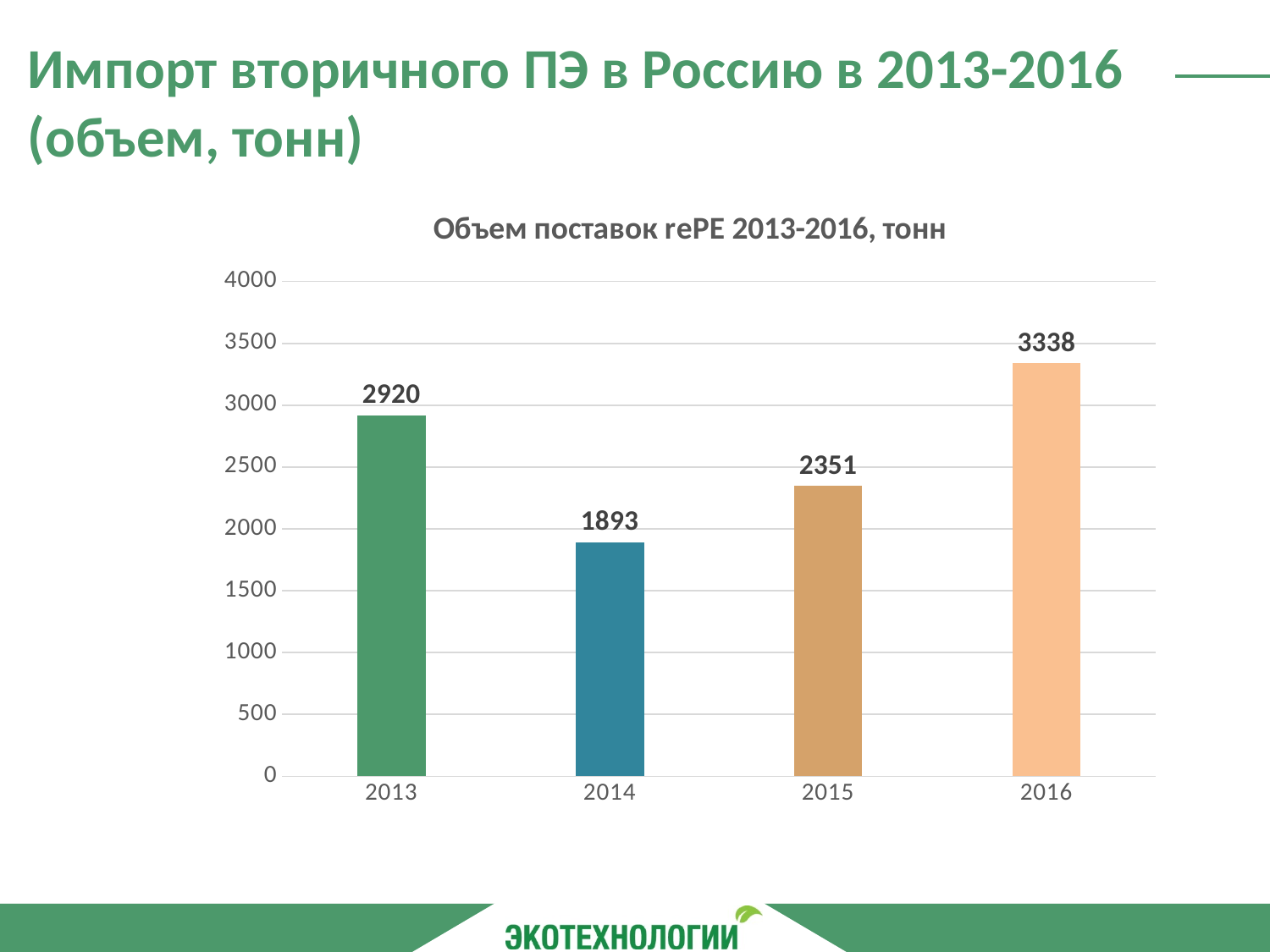
Which is larger, the value for 2013 or the value for 2015? 2013 Which year has the highest value? 2016 Which year has the lowest value? 2014 What is the value for 2014? 1893 How many years are shown on the chart? 4 What is the value for 2015? 2351 What is the difference between the values for 2016 and 2013? 418 What kind of chart is shown on the slide? Bar chart What is the value for 2013? 2920 What is the value for 2016? 3338 What is the title of the chart? Объем поставок rePE 2013-2016, тонн What is the difference between the values for 2015 and 2014? 458